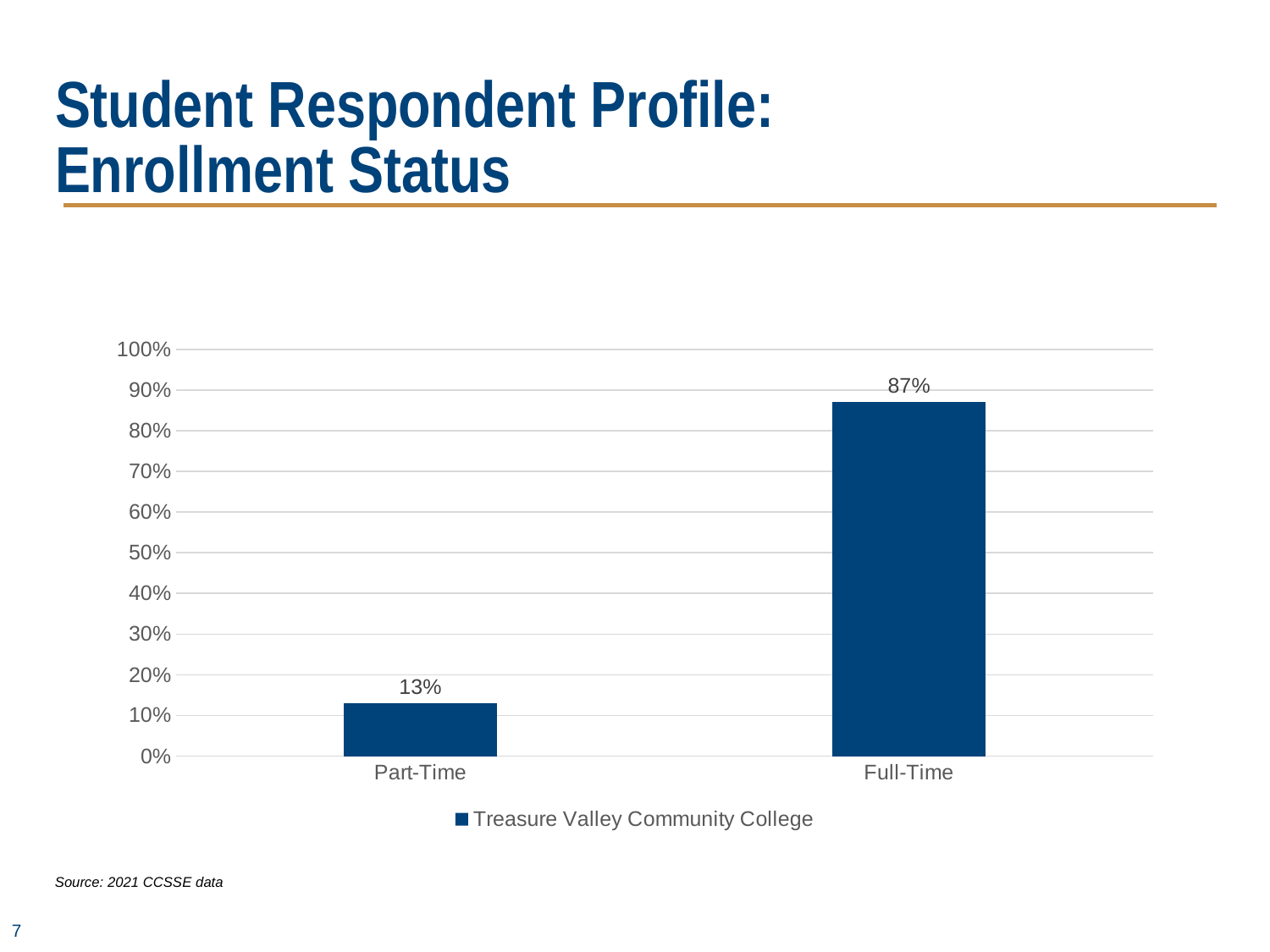
What series name is shown in the legend? Treasure Valley Community College How many series does the legend list? 1 Which category has the highest value? Full-Time Is the value for Full-Time greater or less than 80%? greater What is the value for Full-Time? 87% What is the difference between the Full-Time and Part-Time values? 74% Which category has the lowest value? Part-Time What is the value for Part-Time? 13% Which is larger, the value for Part-Time or the value for Full-Time? Full-Time What kind of chart is shown on the slide? Bar chart How many categories are shown on the x axis? 2 Is the value for Part-Time greater or less than 20%? less